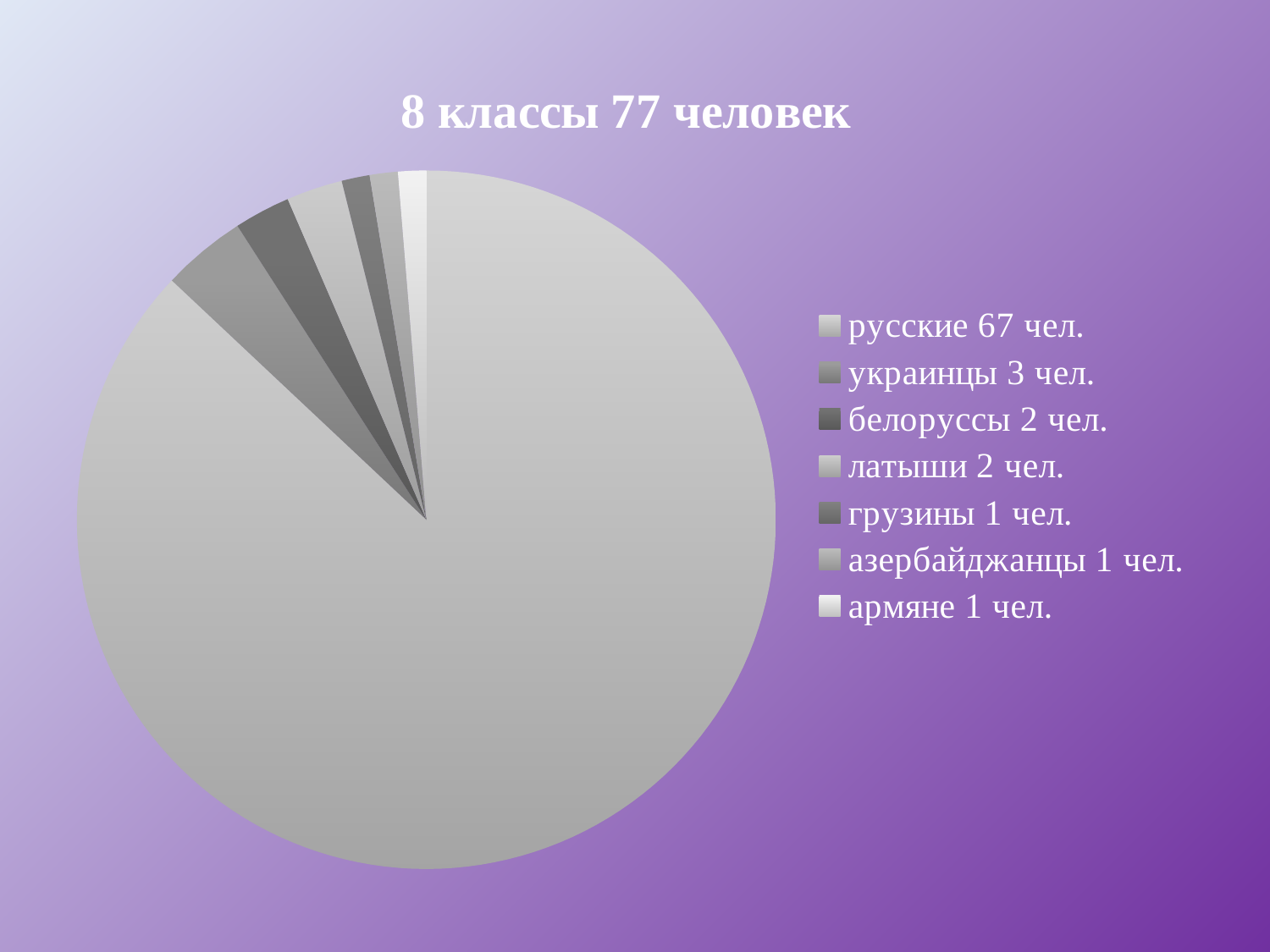
How many categories does the pie chart have? 7 What is the total number of people represented in the pie chart? 77 How many people are in the армяне category? 1 чел. What is the difference between the number of русские and the number of украинцы? 64 Which category has the largest slice of the pie? русские How many people are in the украинцы category? 3 чел. How many people are in the русские category? 67 чел. What is the title of the chart? 8 классы 77 человек How many categories in the legend have exactly 1 чел.? 3 Which is larger, the value for украинцы or the value for белоруссы? украинцы How many people are in the латыши category? 2 чел. What kind of chart is shown on the slide? pie chart